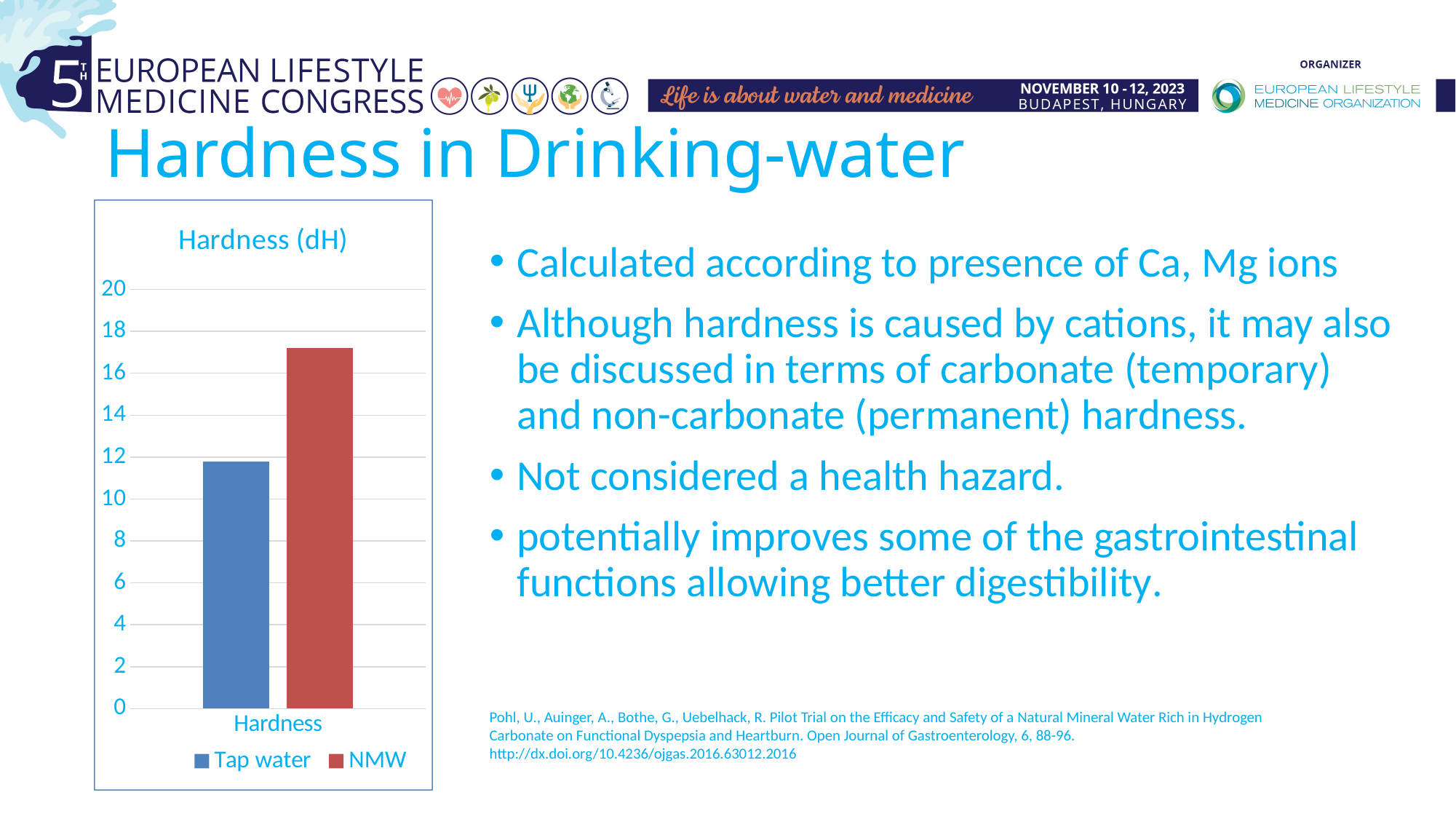
How many series does the chart legend list? 2 Is the hardness value for NMW greater or less than 16? greater How many categories are shown on the x axis of the chart? 1 Is the hardness value for Tap water greater or less than 10? greater Which series has the lower hardness value? Tap water What is the title of the chart? Hardness (dH) Which is larger, the hardness of Tap water or of NMW? NMW What colour is the bar for NMW in the chart? red Which series has the higher hardness value? NMW What kind of chart is shown on the slide? bar chart Is the hardness value for NMW greater or less than 18? less